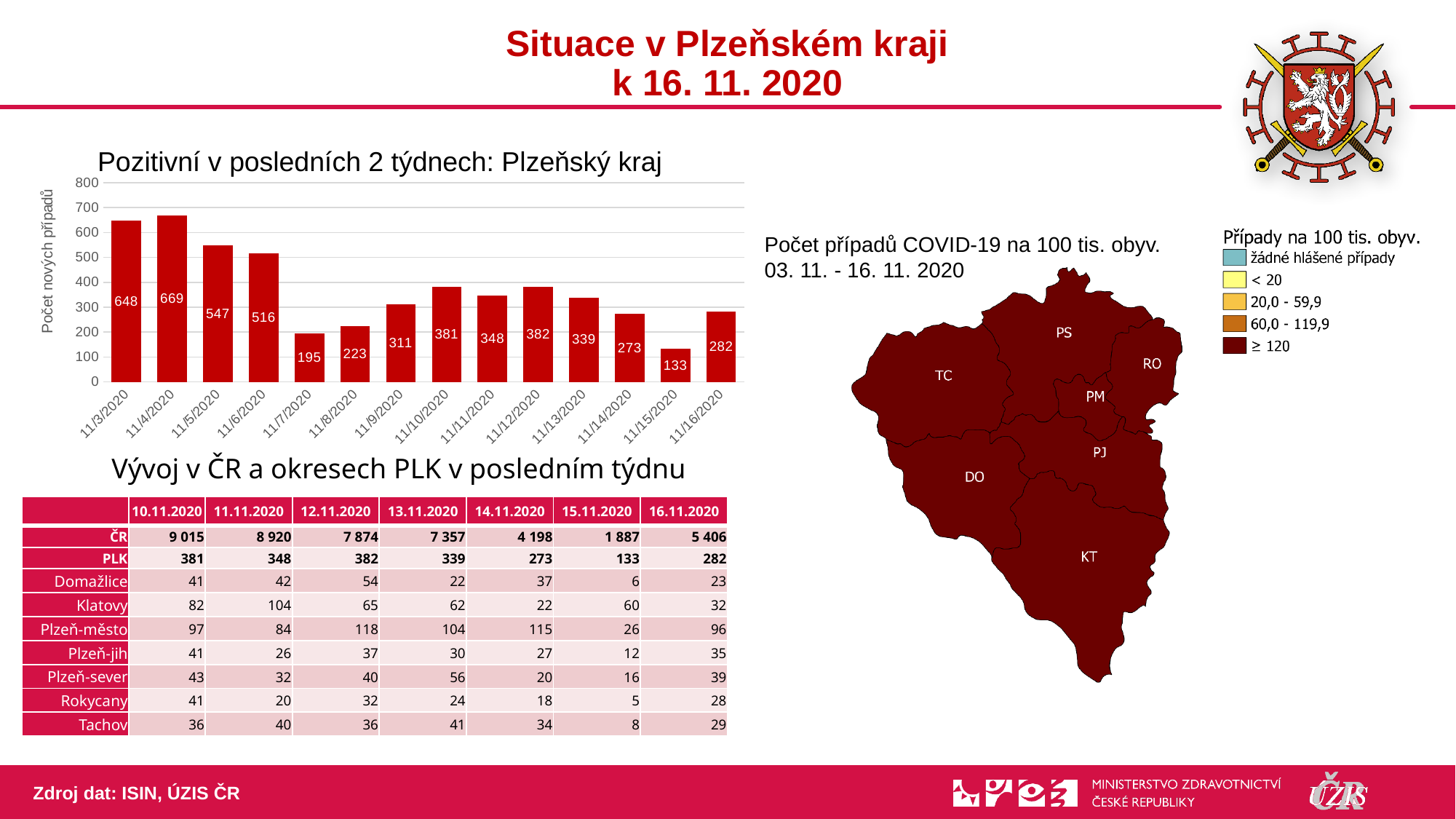
What is the label of the vertical axis of the bar chart? Počet nových případů Is the value for 11/5/2020 in the bar chart greater or less than 500? greater Which date has the highest value in the bar chart? 11/4/2020 What is the value for 11/4/2020 in the bar chart? 669 Which date has the lowest value in the bar chart? 11/15/2020 What type of chart is shown under the title "Pozitivní v posledních 2 týdnech: Plzeňský kraj"? bar chart What is the difference between the values for 11/3/2020 and 11/16/2020 in the bar chart? 366 Which is larger in the bar chart, the value for 11/7/2020 or the value for 11/8/2020? 11/8/2020 What is the value for 11/15/2020 in the bar chart? 133 How many bars are shown in the bar chart? 14 Do the values in the bar chart rise or fall from 11/4/2020 to 11/7/2020? fall What is the value for 11/9/2020 in the bar chart? 311